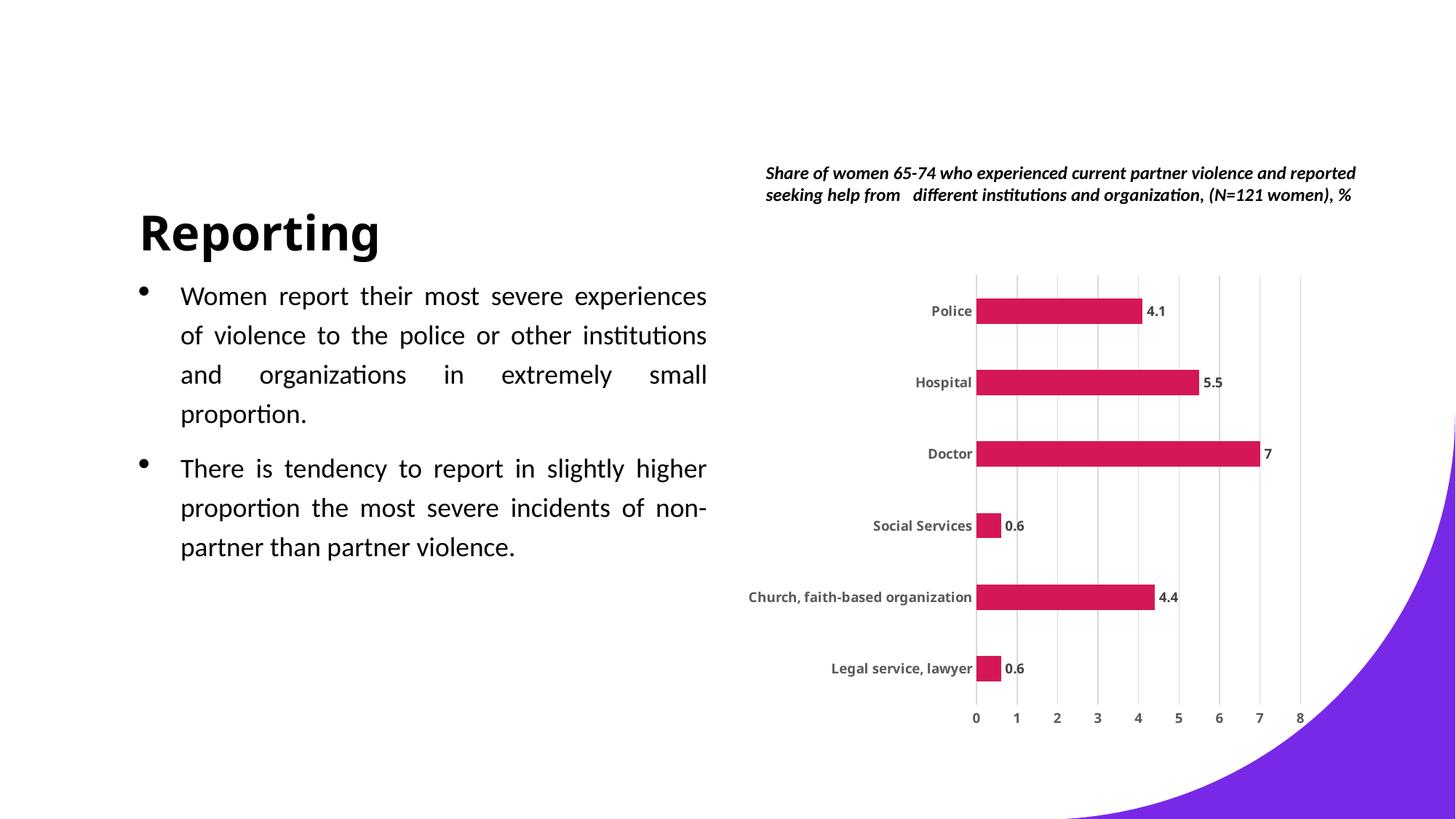
What is the value for Church, faith-based organization? 4.4 What is the difference between the values for Doctor and Hospital? 1.5 Which category has the highest value? Doctor What is the value for Police? 4.1 What is the difference between the values for Church, faith-based organization and Police? 0.3 What is the value for Social Services? 0.6 How many categories are shown in the chart? 6 What is the value for Doctor? 7 Is the value for Hospital greater or less than 5? greater What is the value for Hospital? 5.5 What kind of chart is shown on the slide? bar chart Which is larger, the value for Police or the value for Church, faith-based organization? Church, faith-based organization